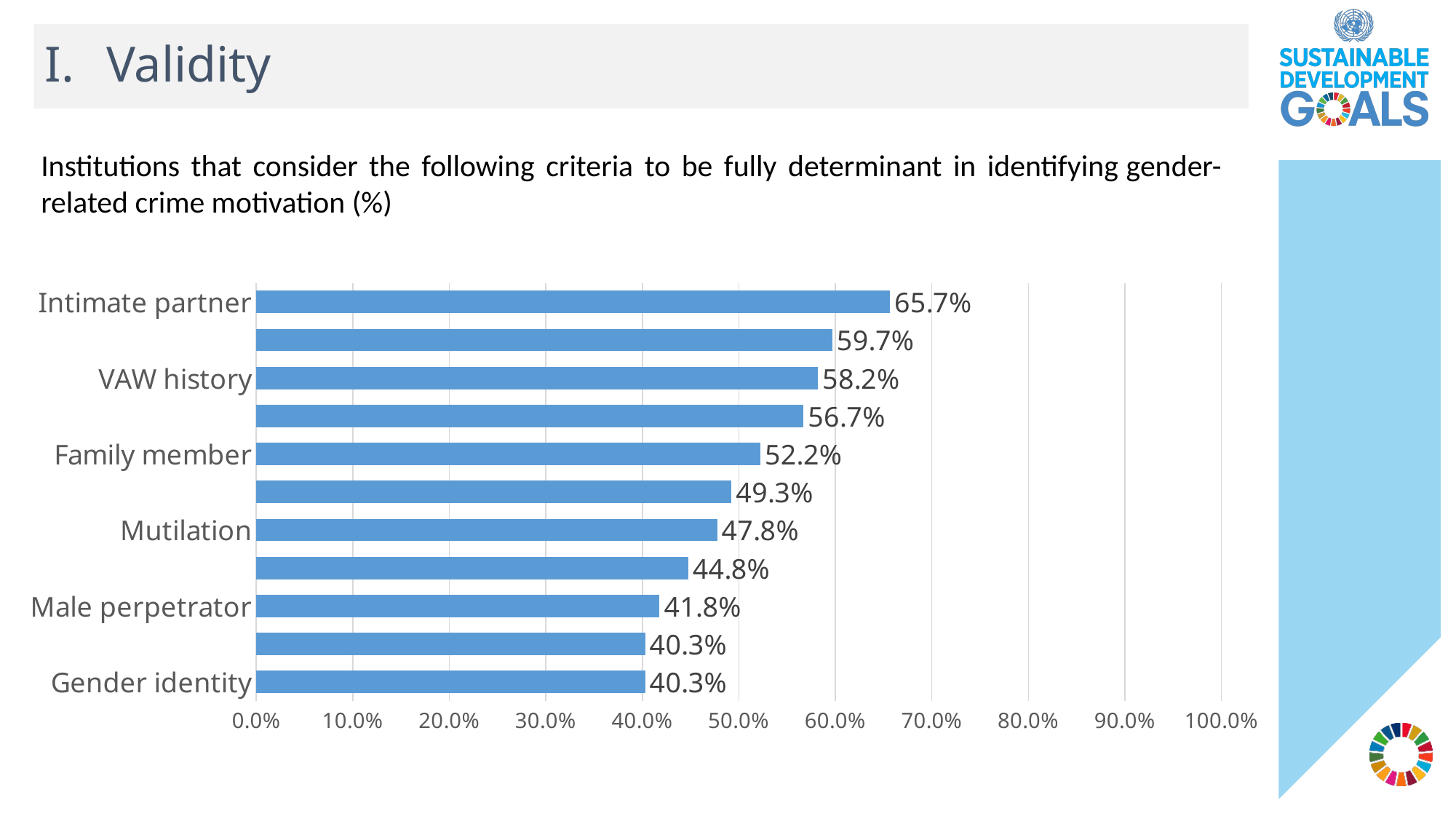
Which is larger, the value for Family member or the value for Mutilation? Family member What is the value for Intimate partner? 65.7% What kind of chart is shown on the slide? Bar chart What is the value for Family member? 52.2% Is the value for Mutilation greater or less than 50.0%? less What is the value for Mutilation? 47.8% How many bars are plotted in the chart? 11 What is the value for VAW history? 58.2% What is the difference in percentage points between Intimate partner and VAW history? 7.5 Which category has the highest value? Intimate partner What is the value for Gender identity? 40.3% What is the value for Male perpetrator? 41.8%